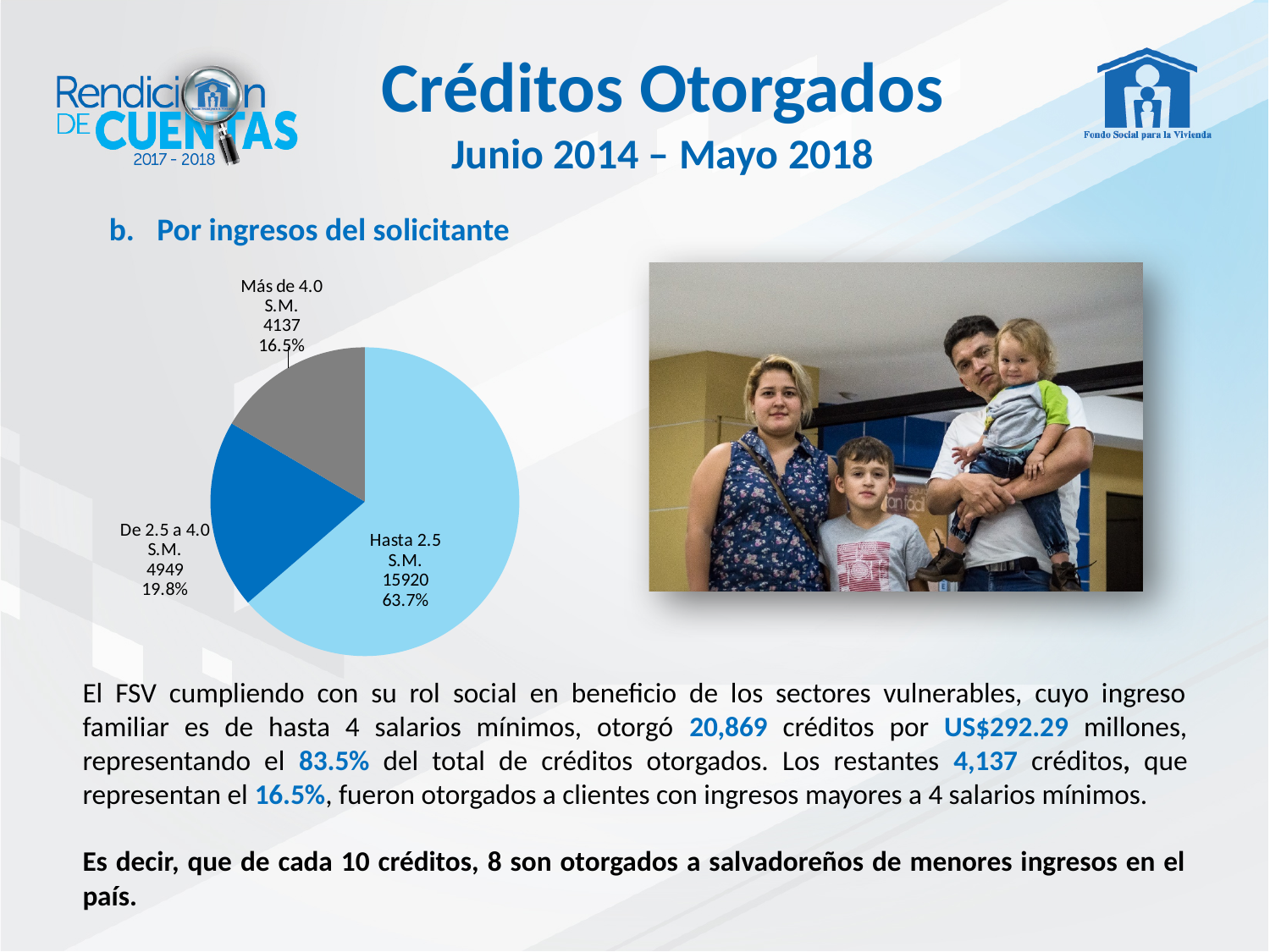
What share of the pie does the 'De 2.5 a 4.0 S.M.' slice represent? 19.8% How many credits were granted to applicants in the 'Hasta 2.5 S.M.' category? 15920 What is the difference in credits between 'De 2.5 a 4.0 S.M.' and 'Más de 4.0 S.M.'? 812 Which has more credits: 'De 2.5 a 4.0 S.M.' or 'Más de 4.0 S.M.'? De 2.5 a 4.0 S.M. What kind of chart is shown on the slide? pie chart Which income category has the smallest number of credits? Más de 4.0 S.M. Which income category has the largest number of credits? Hasta 2.5 S.M. What colour is the 'Más de 4.0 S.M.' slice of the pie chart? gray What percentage is shown for the 'Hasta 2.5 S.M.' slice? 63.7% How many slices does the pie chart have? 3 What is the difference in credits between 'Hasta 2.5 S.M.' and 'De 2.5 a 4.0 S.M.'? 10971 How many credits correspond to the 'Más de 4.0 S.M.' category? 4137